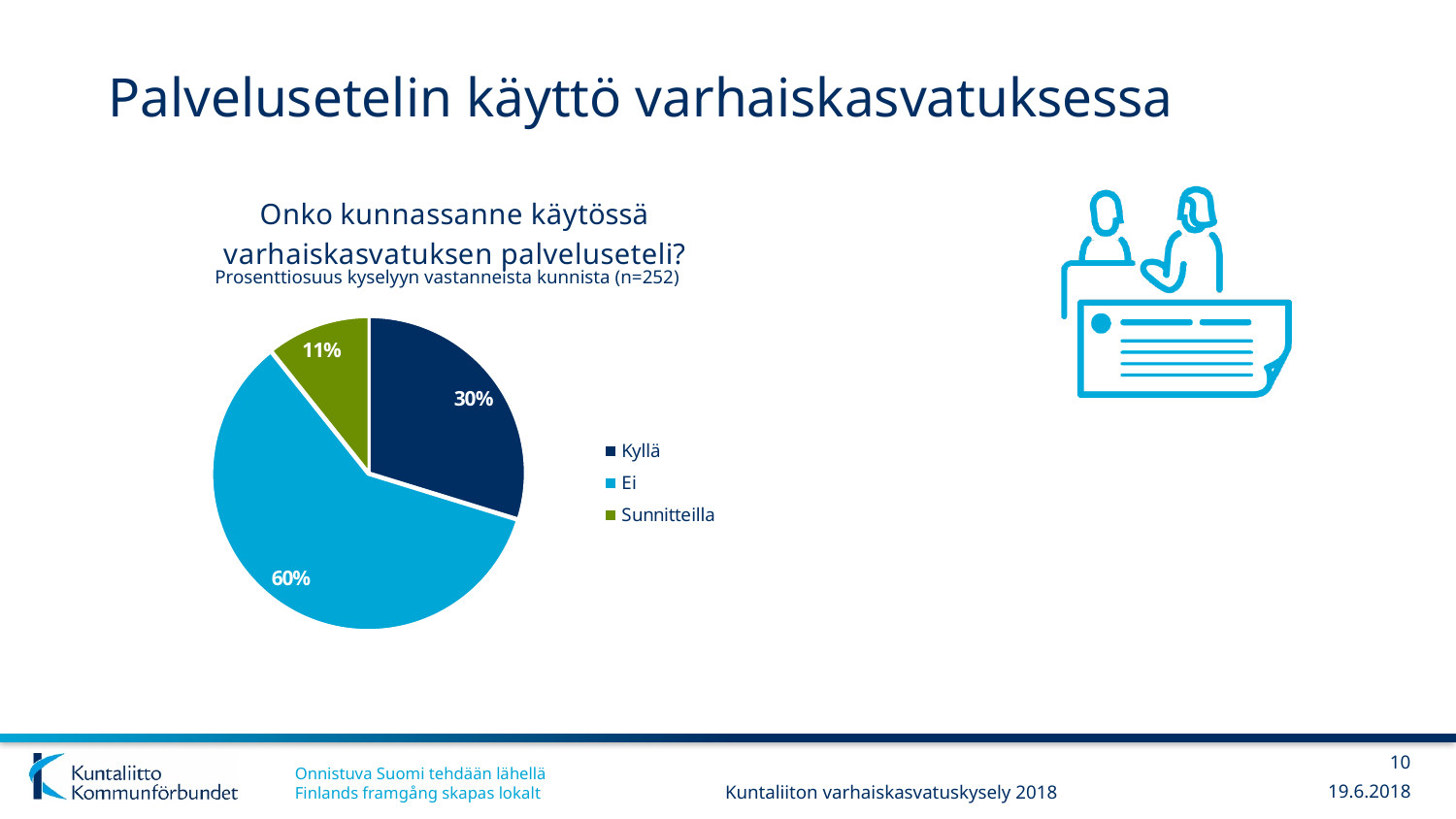
What is the difference in percentage points between "Ei" and "Kyllä"? 30 How many categories does the pie chart have? 3 Which is larger, the share for "Kyllä" or the share for "Sunnitteilla"? Kyllä What percentage of municipalities answered "Ei"? 60% What percentage of municipalities answered "Sunnitteilla"? 11% Which category has the largest share of the pie? Ei What kind of chart is shown on the slide? pie chart Which colour represents "Sunnitteilla" in the pie chart? green What percentage of municipalities answered "Kyllä"? 30% What is the difference in percentage points between "Kyllä" and "Sunnitteilla"? 19 How many respondents (n) does the chart subtitle state? 252 Which category has the smallest share of the pie? Sunnitteilla